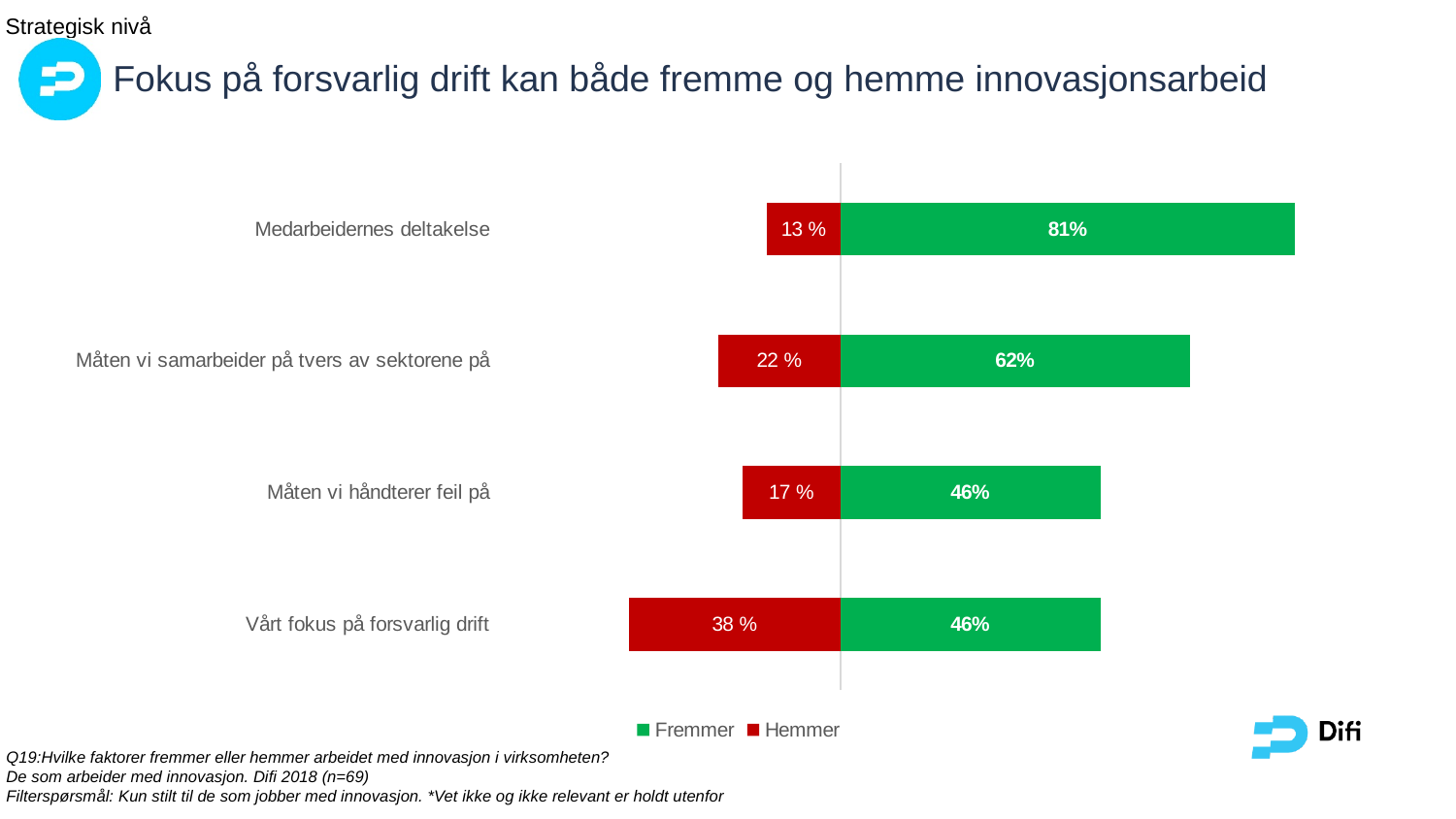
What is the Hemmer value for Måten vi håndterer feil på? 17 % What is the Fremmer value for Måten vi samarbeider på tvers av sektorene på? 62% What is the Hemmer value for Vårt fokus på forsvarlig drift? 38 % Which category has the lowest Hemmer value? Medarbeidernes deltakelse What is the Fremmer value for Medarbeidernes deltakelse? 81% What is the difference between the Fremmer values for Medarbeidernes deltakelse and Måten vi håndterer feil på? 35 percentage points Which category has the highest Hemmer value? Vårt fokus på forsvarlig drift Which category has the highest Fremmer value? Medarbeidernes deltakelse How many series does the legend list? 2 Which is larger: the Hemmer value for Måten vi samarbeider på tvers av sektorene på or the Hemmer value for Måten vi håndterer feil på? Måten vi samarbeider på tvers av sektorene på How many categories are shown in the chart? 4 What kind of chart is shown on the slide? Bar chart